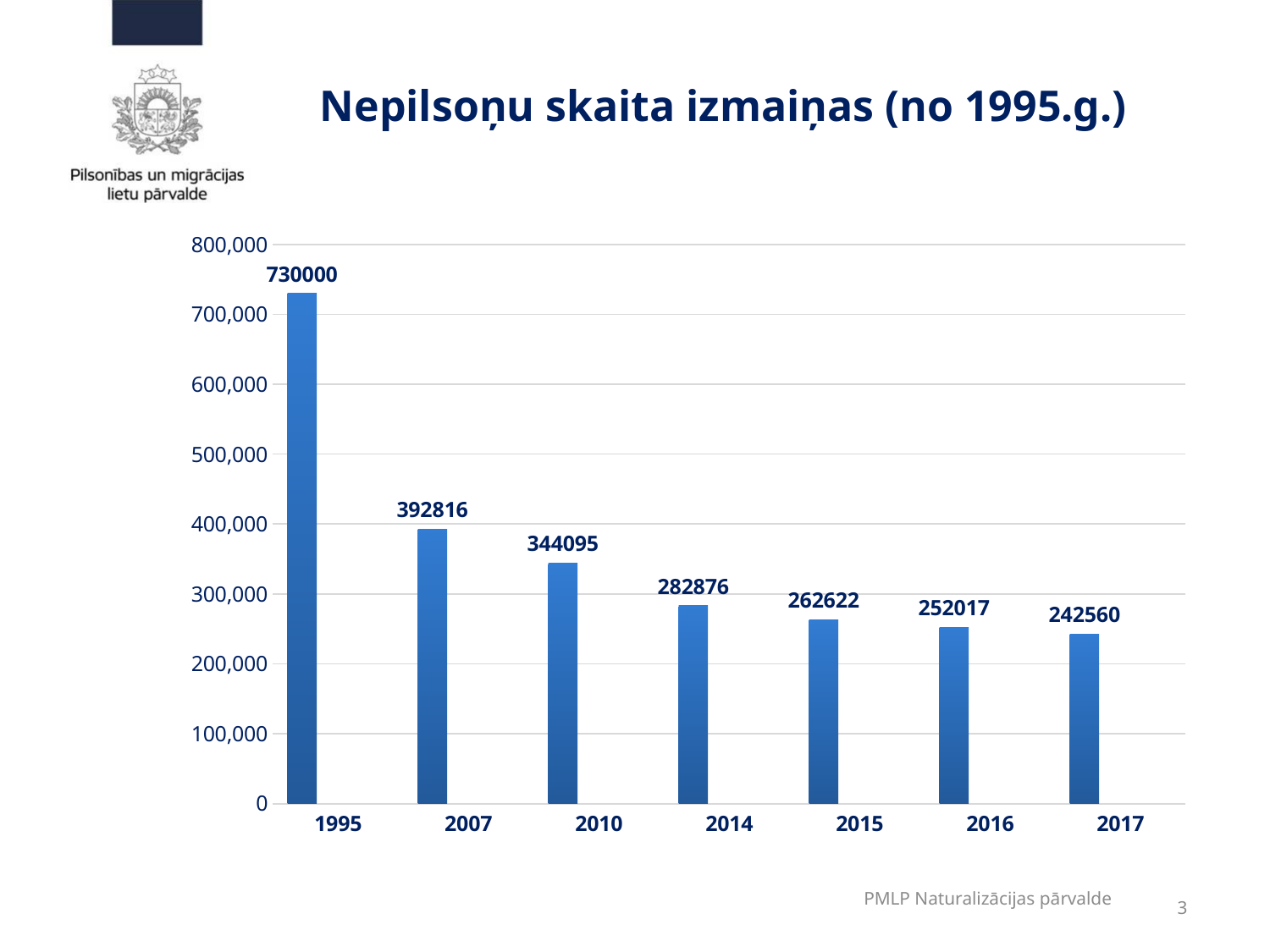
What kind of chart is shown on the slide? bar chart Do the values rise or fall from 1995 to 2017? fall Which year has the highest value? 1995 Is the value for 2010 greater or less than 300,000? greater What is the value for 2017? 242560 Which is larger, the value for 2015 or the value for 2016? 2015 What is the value for 2014? 282876 Which year has the lowest value? 2017 How many years are shown on the x axis? 7 What is the value for 1995? 730000 What is the difference between the values for 2007 and 2010? 48721 What is the difference between the values for 1995 and 2017? 487440